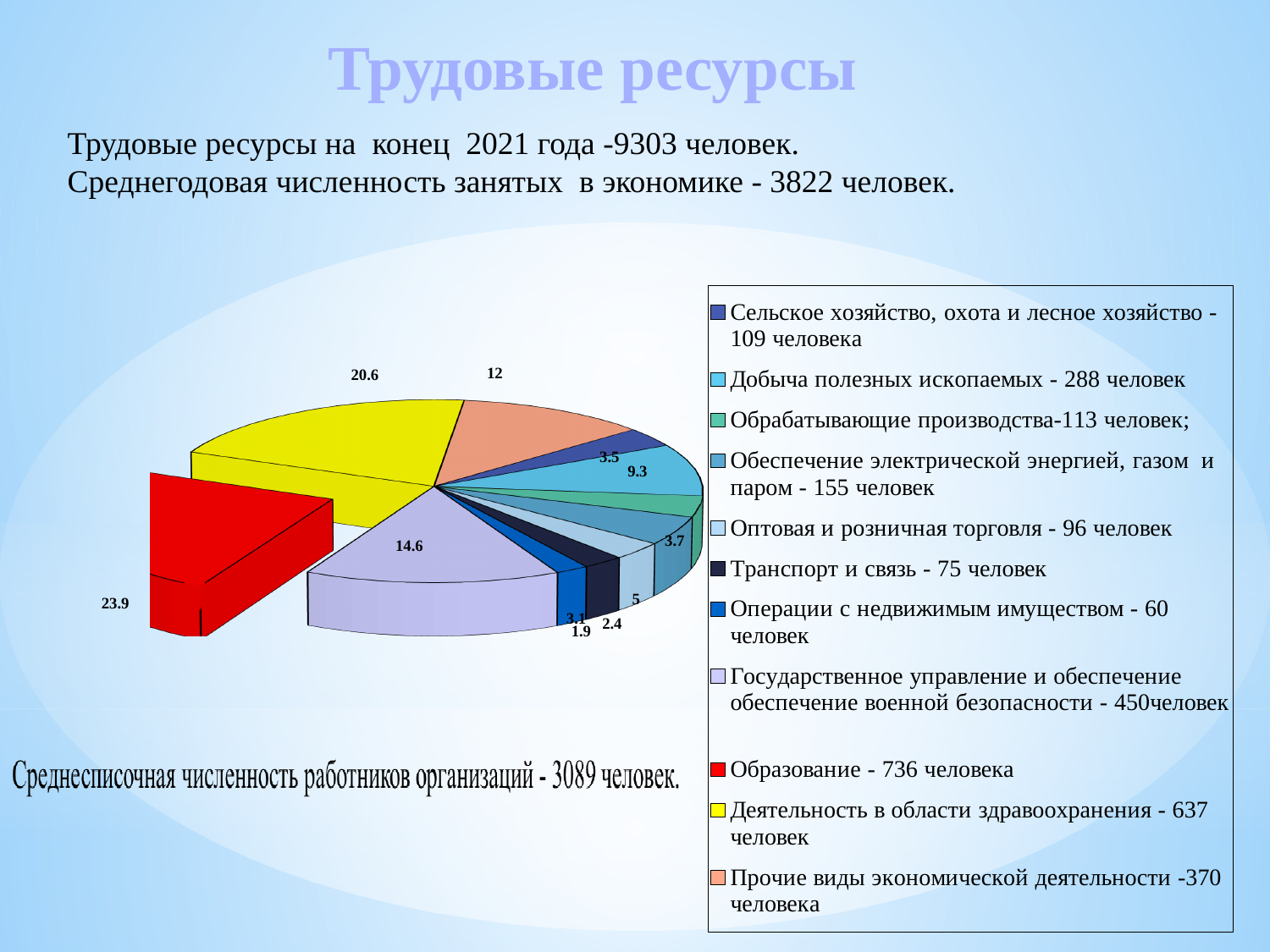
What kind of chart is shown on the slide? pie chart What value is labelled on the slice for Добыча полезных ископаемых? 9.3 According to the legend, how many people are in the Образование category? 736 человека Which category has the largest slice in the pie chart? Образование What value is labelled on the lavender slice (Государственное управление и обеспечение военной безопасности)? 14.6 What value is labelled on the yellow slice (Деятельность в области здравоохранения)? 20.6 Which slice is larger: Добыча полезных ископаемых or Обрабатывающие производства? Добыча полезных ископаемых How many categories does the legend of the pie chart list? 11 Which slice is pulled out (exploded) from the pie chart? the red slice, Образование What value is labelled on the red slice (Образование) of the pie chart? 23.9 What is the difference between the labelled values of the Образование slice and the Здравоохранение slice? 3.3 What value is labelled on the slice for Прочие виды экономической деятельности? 12